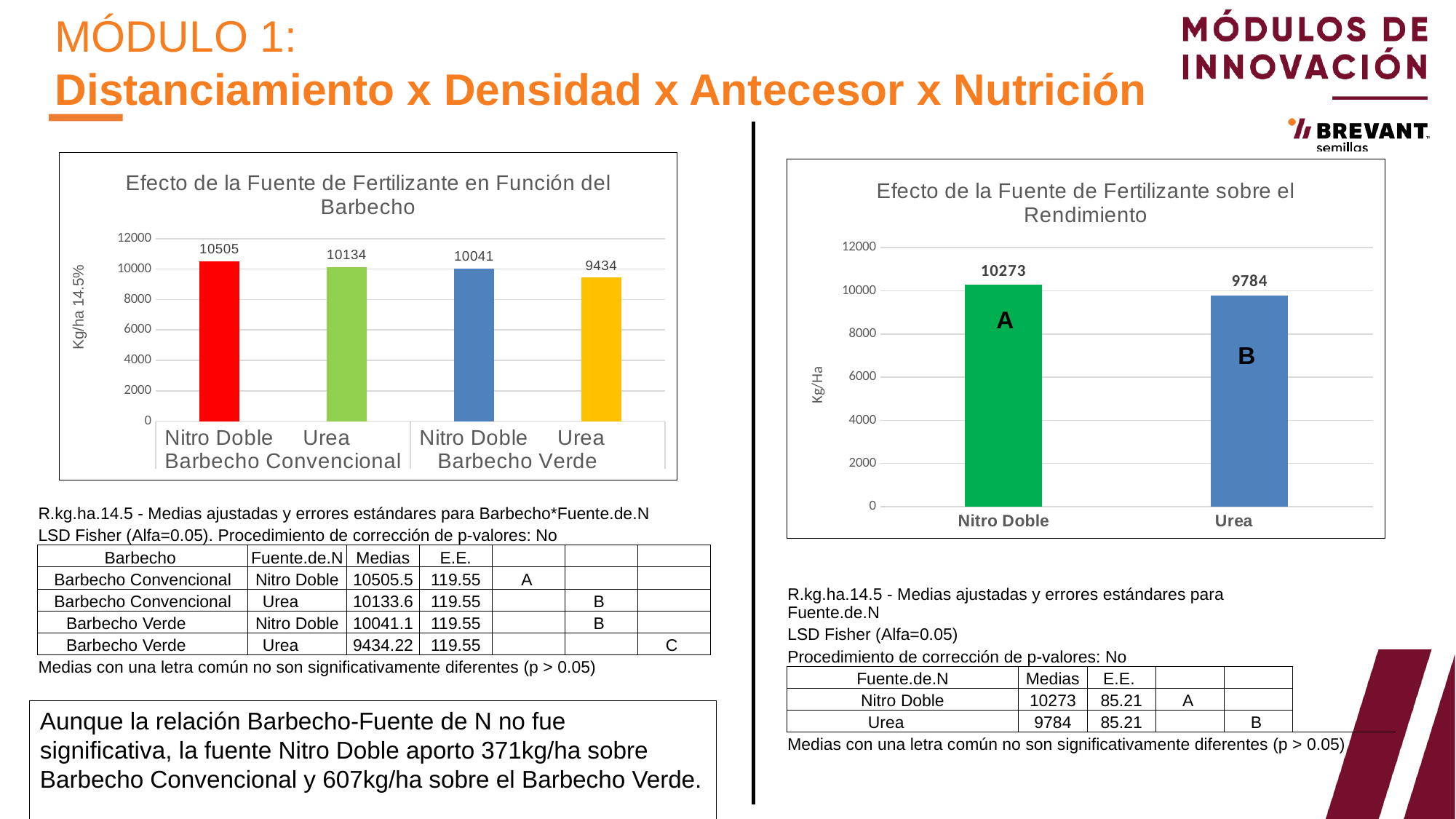
In the chart 'Efecto de la Fuente de Fertilizante en Función del Barbecho', what is the difference between Nitro Doble and Urea under Barbecho Verde? 607 In the chart 'Efecto de la Fuente de Fertilizante en Función del Barbecho', which bar has the lowest value? Urea, Barbecho Verde In the chart 'Efecto de la Fuente de Fertilizante en Función del Barbecho', what is the value for Urea under Barbecho Verde? 9434 In the chart 'Efecto de la Fuente de Fertilizante sobre el Rendimiento', what is the value for Urea? 9784 What kind of chart is 'Efecto de la Fuente de Fertilizante sobre el Rendimiento'? Bar chart In the chart 'Efecto de la Fuente de Fertilizante sobre el Rendimiento', what is the difference between Nitro Doble and Urea? 489 In the chart 'Efecto de la Fuente de Fertilizante sobre el Rendimiento', which category has the larger value, Nitro Doble or Urea? Nitro Doble In the chart 'Efecto de la Fuente de Fertilizante en Función del Barbecho', how many bars are plotted? 4 In the chart 'Efecto de la Fuente de Fertilizante en Función del Barbecho', what is the y-axis label? Kg/ha 14.5% In the chart 'Efecto de la Fuente de Fertilizante en Función del Barbecho', what is the value for Nitro Doble under Barbecho Convencional? 10505 In the chart 'Efecto de la Fuente de Fertilizante en Función del Barbecho', which bar has the highest value? Nitro Doble, Barbecho Convencional In the chart 'Efecto de la Fuente de Fertilizante sobre el Rendimiento', what is the value for Nitro Doble? 10273